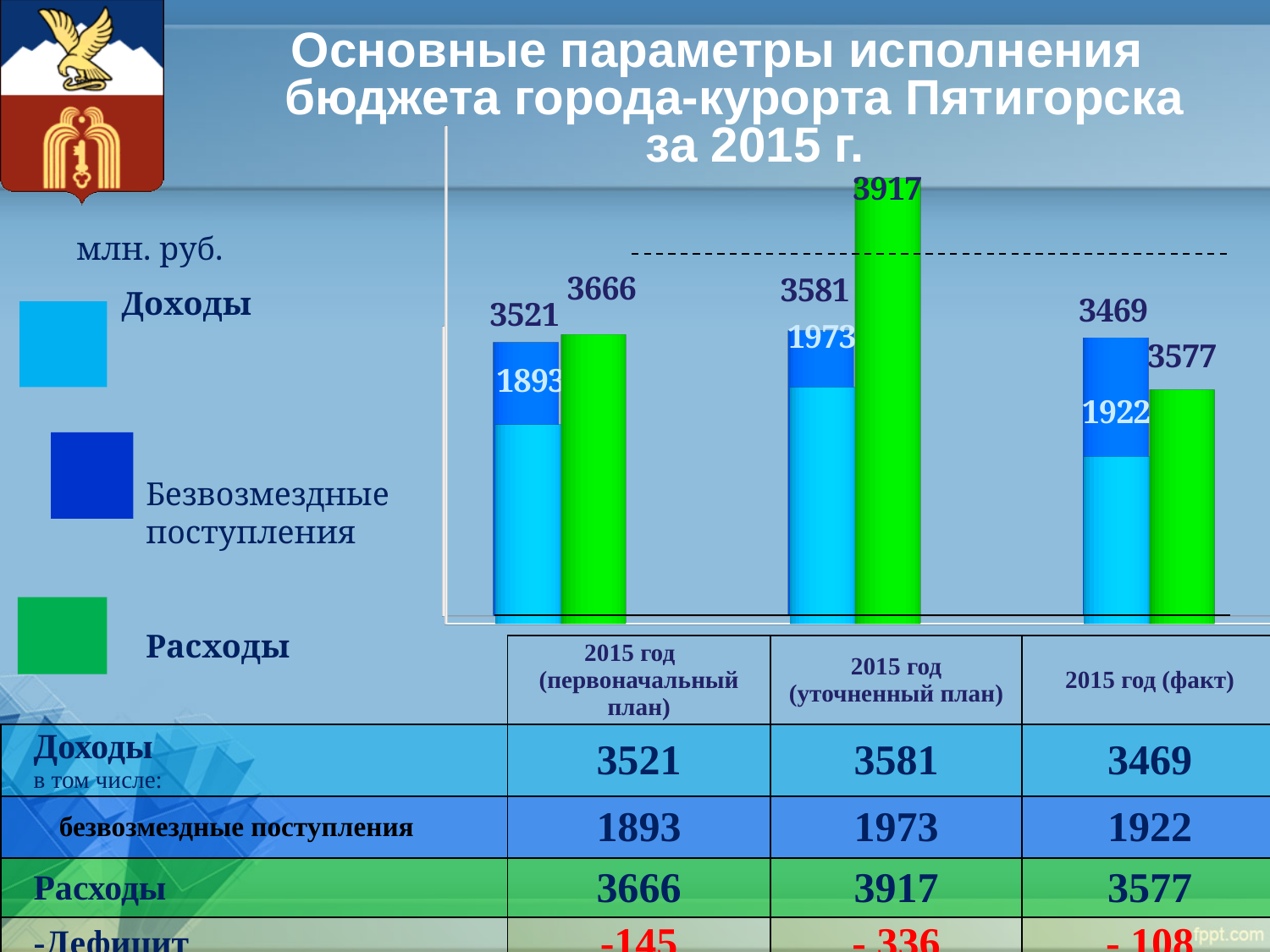
By how much do Расходы exceed Доходы for 2015 год (факт)? 108 What is the value of Доходы for 2015 год (факт)? 3469 How many categories (groups of bars) are shown on the chart? 3 What is the value of Расходы for 2015 год (уточненный план)? 3917 Which category has the highest Расходы? 2015 год (уточненный план) What is the value of Безвозмездные поступления for 2015 год (первоначальный план)? 1893 Which category has the lowest Доходы? 2015 год (факт) What is the difference between Доходы for 2015 год (уточненный план) and 2015 год (первоначальный план)? 60 Do Доходы rise or fall from 2015 год (уточненный план) to 2015 год (факт)? fall How many series does the legend list? 3 For 2015 год (первоначальный план), which is larger: Доходы or Расходы? Расходы What kind of chart is shown on the slide? bar chart